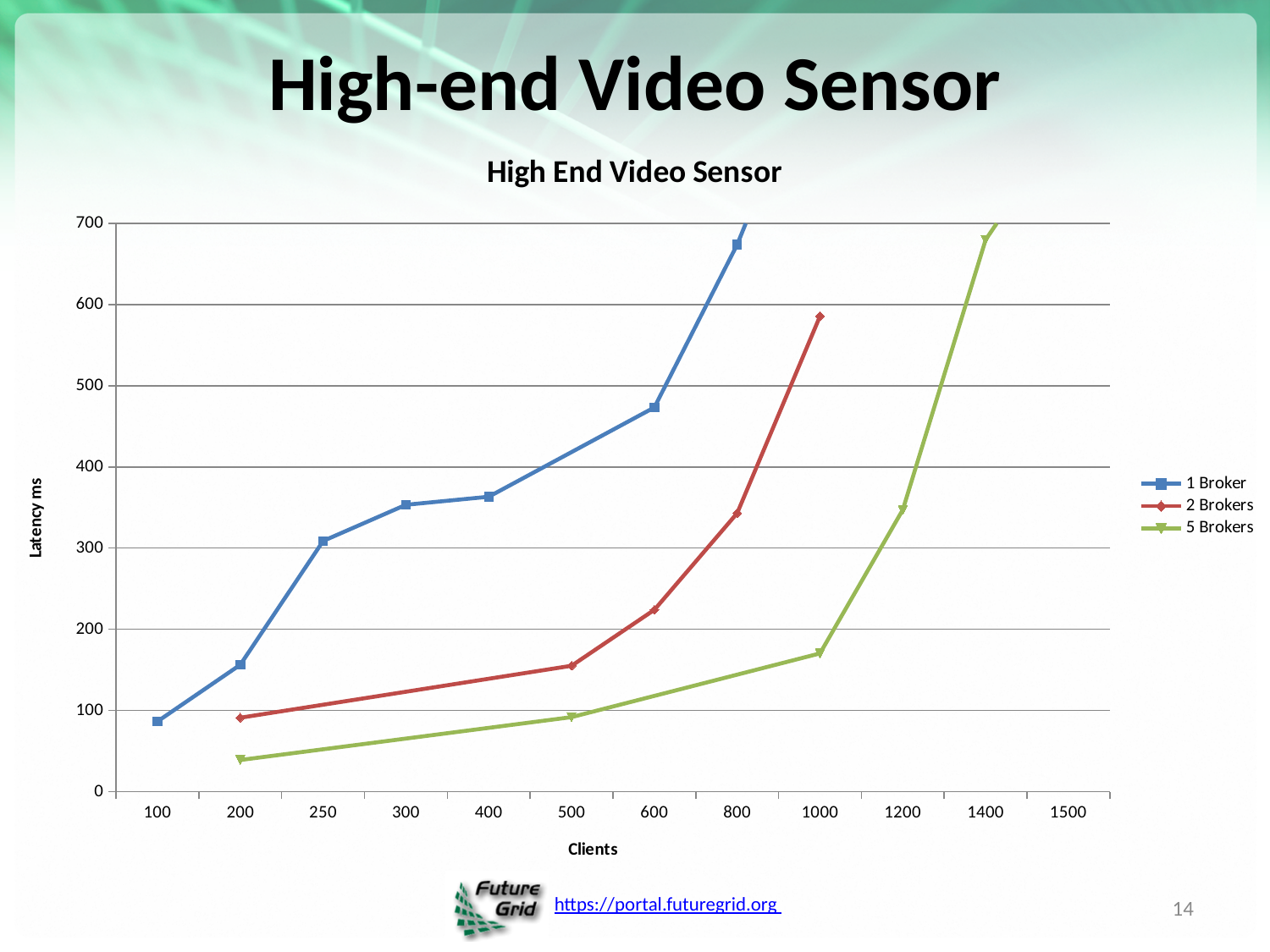
How many client values are labelled on the x axis? 12 What kind of chart is shown on the slide? line chart At 200 clients, which has the higher latency: 1 Broker or 5 Brokers? 1 Broker At 1000 clients, which has the higher latency: 2 Brokers or 5 Brokers? 2 Brokers Is the latency for 1 Broker at 800 clients greater or less than 600? greater Is the latency for 1 Broker at 600 clients greater or less than 400? greater Does the latency for 5 Brokers rise or fall as the number of clients increases? rise Is the latency for 2 Brokers at 1000 clients greater or less than 500? greater How many series does the legend list? 3 Which series are listed in the legend? 1 Broker, 2 Brokers, 5 Brokers What is the title of the y axis? Latency ms